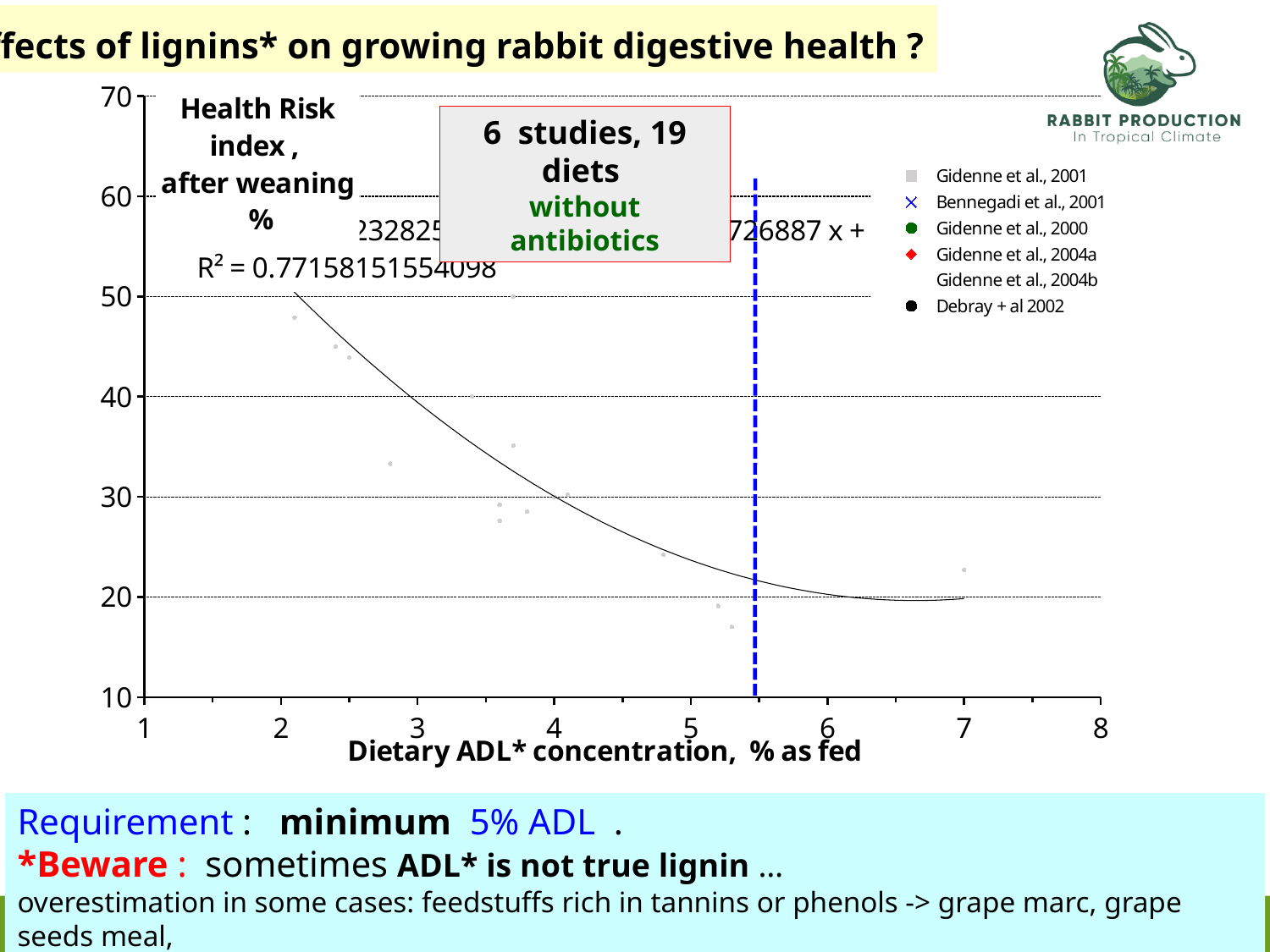
What is the highest value shown on the y axis of the chart? 70 Is the health risk index for the data point at about 7% ADL greater or less than 20? greater Is the health risk index for the lowest data point near 5.3% ADL greater or less than 20? less Does the health risk index generally rise or fall as dietary ADL concentration increases along the x axis? fall According to the text box on the chart, how many diets are included in the analysis? 19 Is the health risk index for the data point at about 2.8% ADL greater or less than 40? less According to the text box on the chart, how many studies are included in the analysis? 6 What is the R² value printed on the chart? 0.77158151554098 What kind of chart is shown on the slide? scatter chart How many series does the chart legend list? 6 What is the label of the x axis of the chart? Dietary ADL* concentration, % as fed